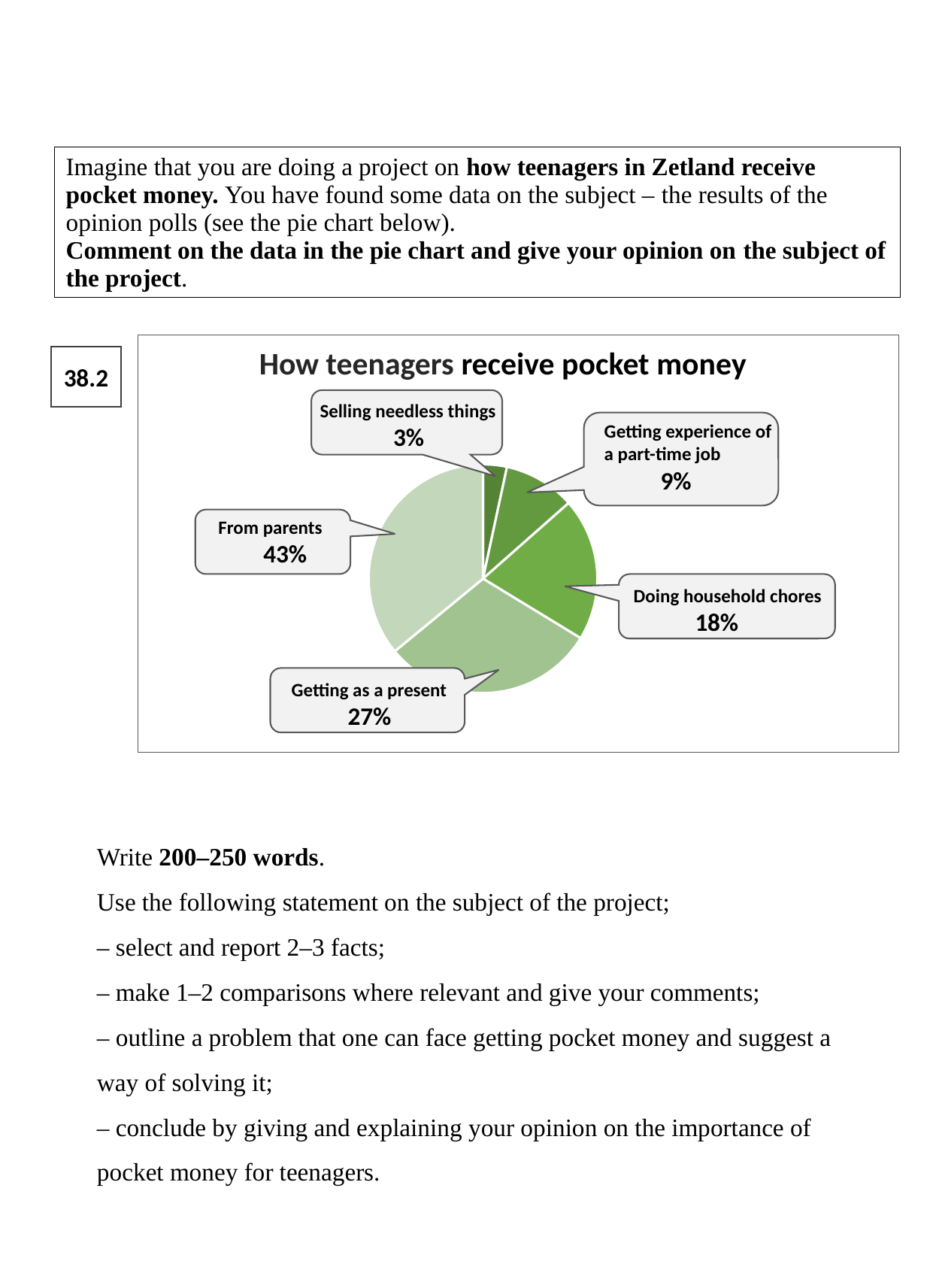
What percentage is shown for 'Selling needless things'? 3% Which category has the smallest share of the pie? Selling needless things How many categories are shown in the pie chart? 5 Which category has the largest share of the pie? From parents What percentage is shown for 'Getting experience of a part-time job'? 9% What share of the pie is 'Getting as a present'? 27% What is the title of the chart? How teenagers receive pocket money What percentage is shown for 'Doing household chores'? 18% Which is larger: 'Doing household chores' or 'Getting experience of a part-time job'? Doing household chores What kind of chart is shown on the slide? Pie chart What percentage of teenagers receive pocket money from parents? 43% What is the difference in percentage points between 'From parents' and 'Getting as a present'? 16